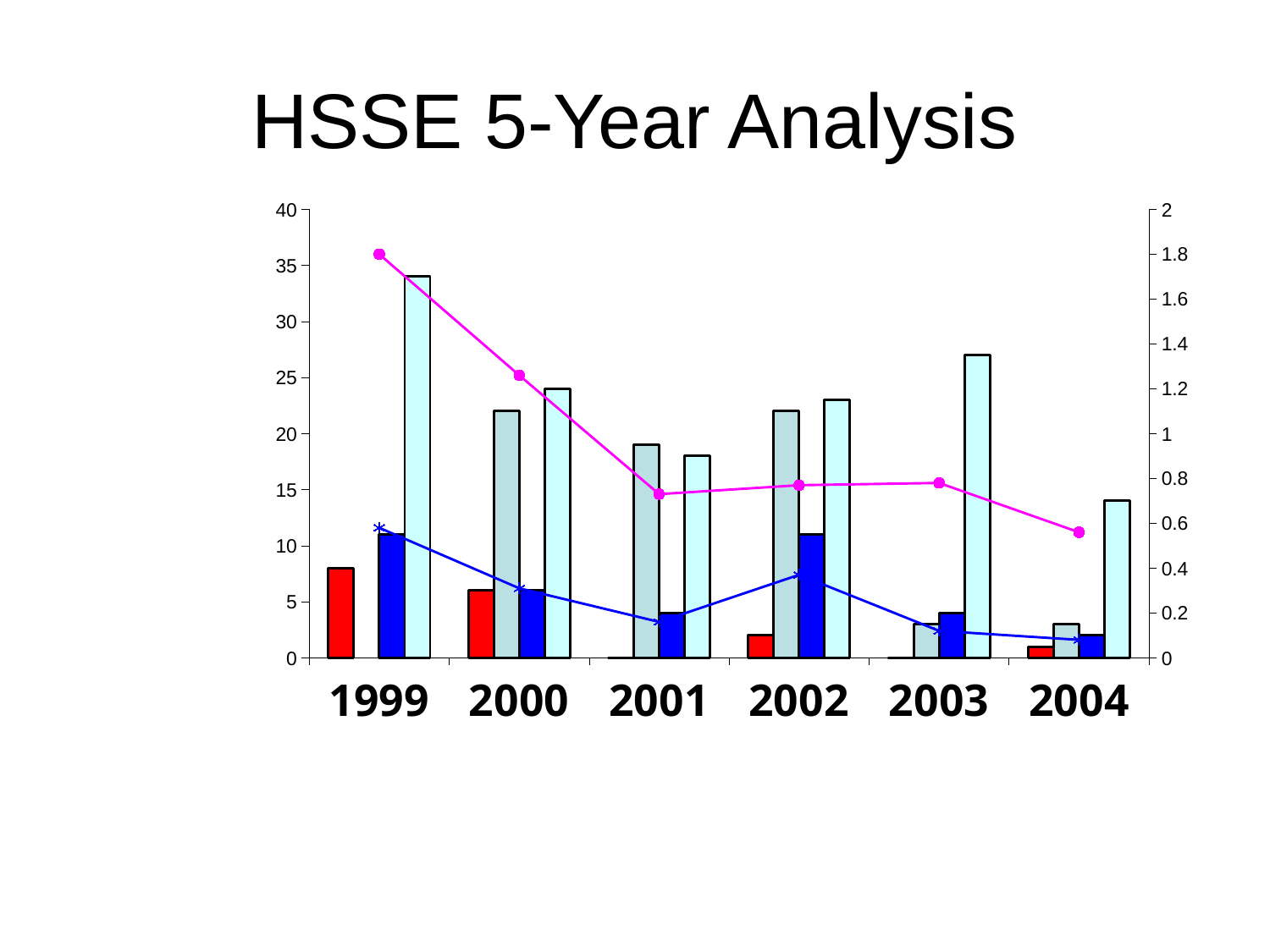
What is the title of the chart on the slide? HSSE 5-Year Analysis Which is taller in 2003, the light cyan bar or the blue bar? The light cyan bar Is the value of the light cyan bar for 1999 greater or less than 30 on the left axis? greater Which year has the taller red bar, 1999 or 2004? 1999 In which year is the light cyan bar the shortest? 2004 In which year is the light cyan bar the tallest? 1999 Is the value of the blue bar for 2002 greater or less than 10 on the left axis? greater Does the magenta line generally rise or fall from 1999 to 2004? Fall What kind of chart is shown on the slide? Combined bar and line chart How many years are shown along the x axis of the chart? 6 Is the value of the light cyan bar for 2004 greater or less than 15 on the left axis? less